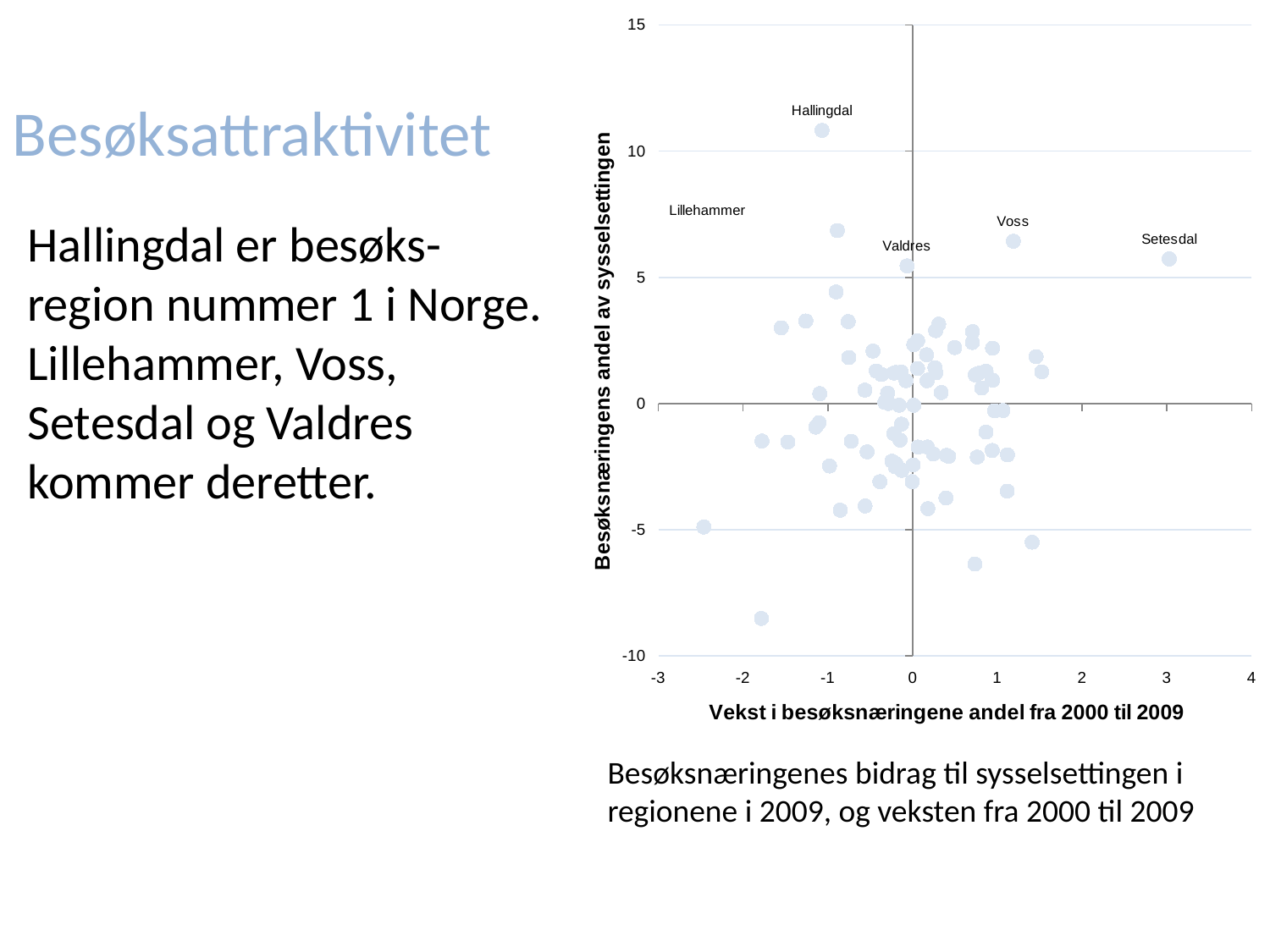
Which has the higher vertical-axis value, Hallingdal or Voss? Hallingdal Is the horizontal-axis value for Voss greater or less than 0? greater Is the vertical-axis value for Hallingdal greater or less than 10? greater Which has the higher vertical-axis value, Lillehammer or Setesdal? Lillehammer What is the title of the horizontal axis of the chart? Vekst i besøksnæringene andel fra 2000 til 2009 Which labelled region has the highest value on the vertical axis (Besøksnæringens andel av sysselsettingen)? Hallingdal How many points on the chart are labelled with a region name? 5 Is the horizontal-axis value (Vekst i besøksnæringene andel fra 2000 til 2009) for Setesdal greater or less than 2? greater Which has the higher horizontal-axis value, Setesdal or Voss? Setesdal What kind of chart is shown on the slide? scatter chart